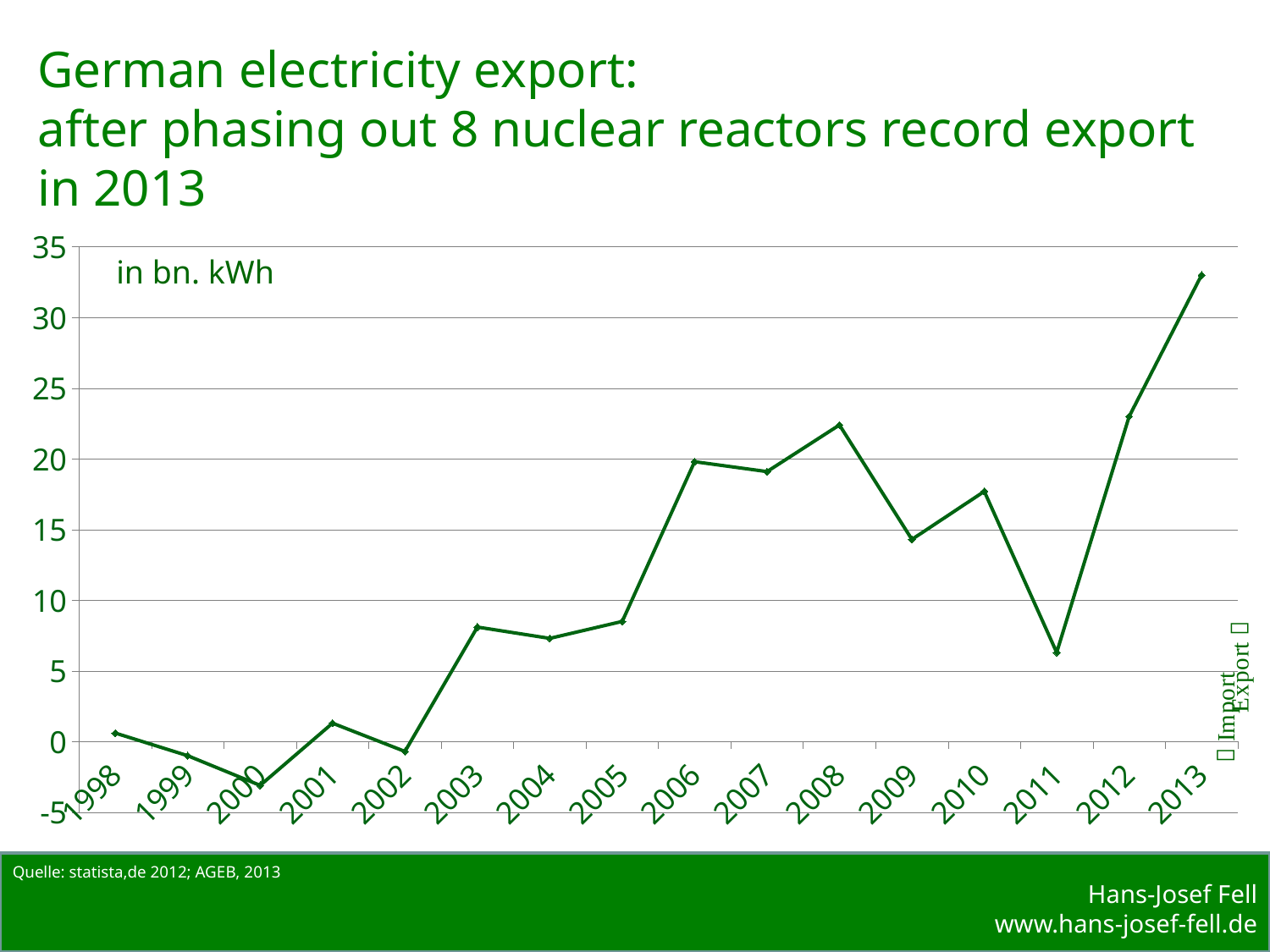
Is the value for 2003 greater or less than 10? less Which year has the lowest electricity export value? 2000 Is the value for 2013 greater or less than 30? greater What kind of chart is shown on the slide? line chart What unit is given for the values in the chart? bn. kWh Overall, do the values rise or fall from 1998 to 2013? rise Which year has the highest electricity export value? 2013 Is the value for 2011 greater or less than 10? less How many years are plotted on the x axis? 16 Which year has the larger value, 2008 or 2009? 2008